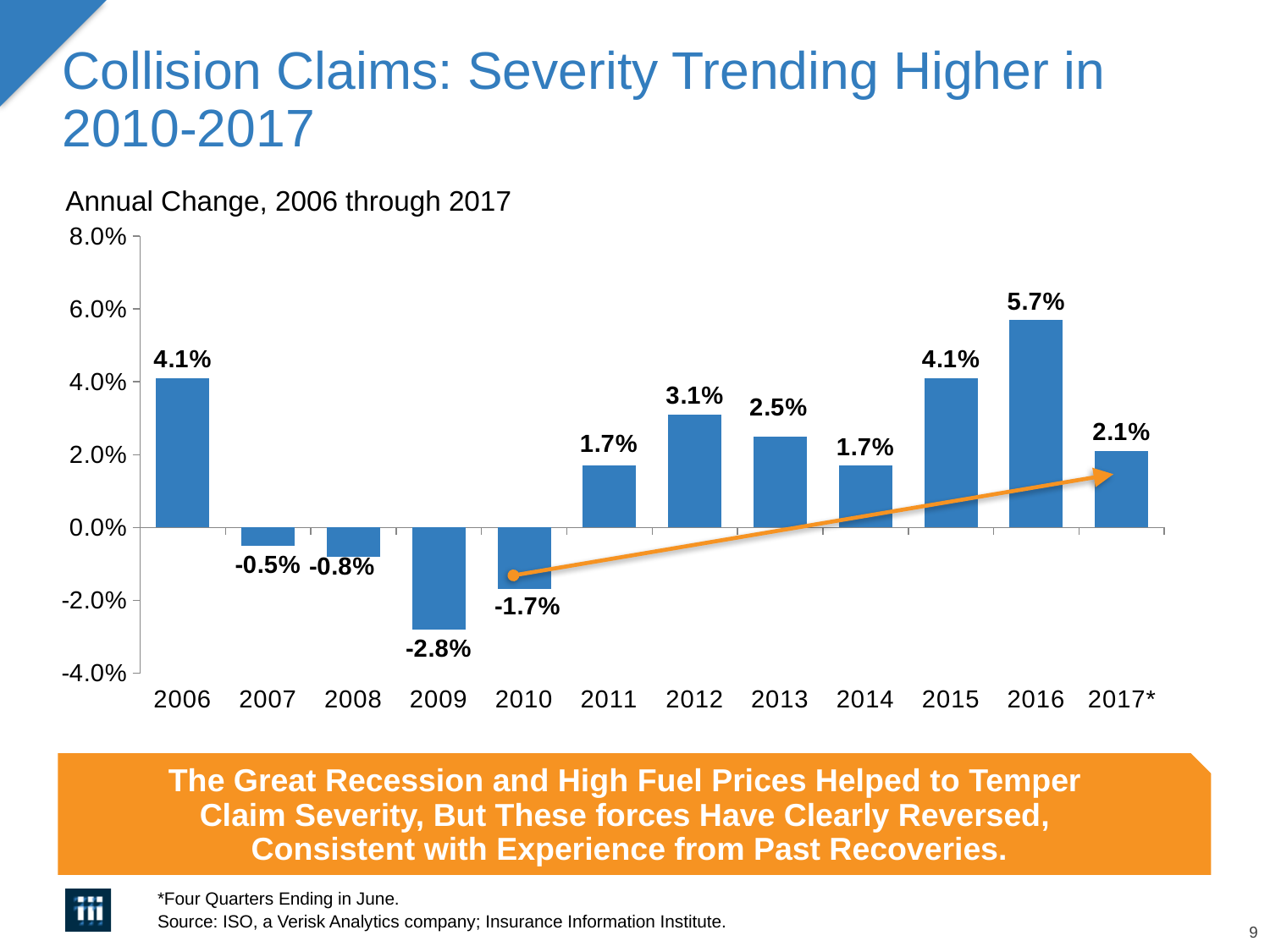
What is the subtitle printed above the chart? Annual Change, 2006 through 2017 What is the annual change in collision claim severity for 2016? 5.7% What is the value shown for 2017*? 2.1% Which year has the lowest annual change? 2009 Which year has the highest annual change? 2016 How many years are shown on the x axis? 12 What is the difference between the 2016 value and the 2015 value? 1.6% What kind of chart is shown on the slide? Bar chart Which is larger, the value for 2006 or the value for 2012? 2006 Is the value for 2016 greater or less than 4.0%? greater What is the annual change shown for 2009? -2.8% What is the difference between the 2012 value and the 2013 value? 0.6%